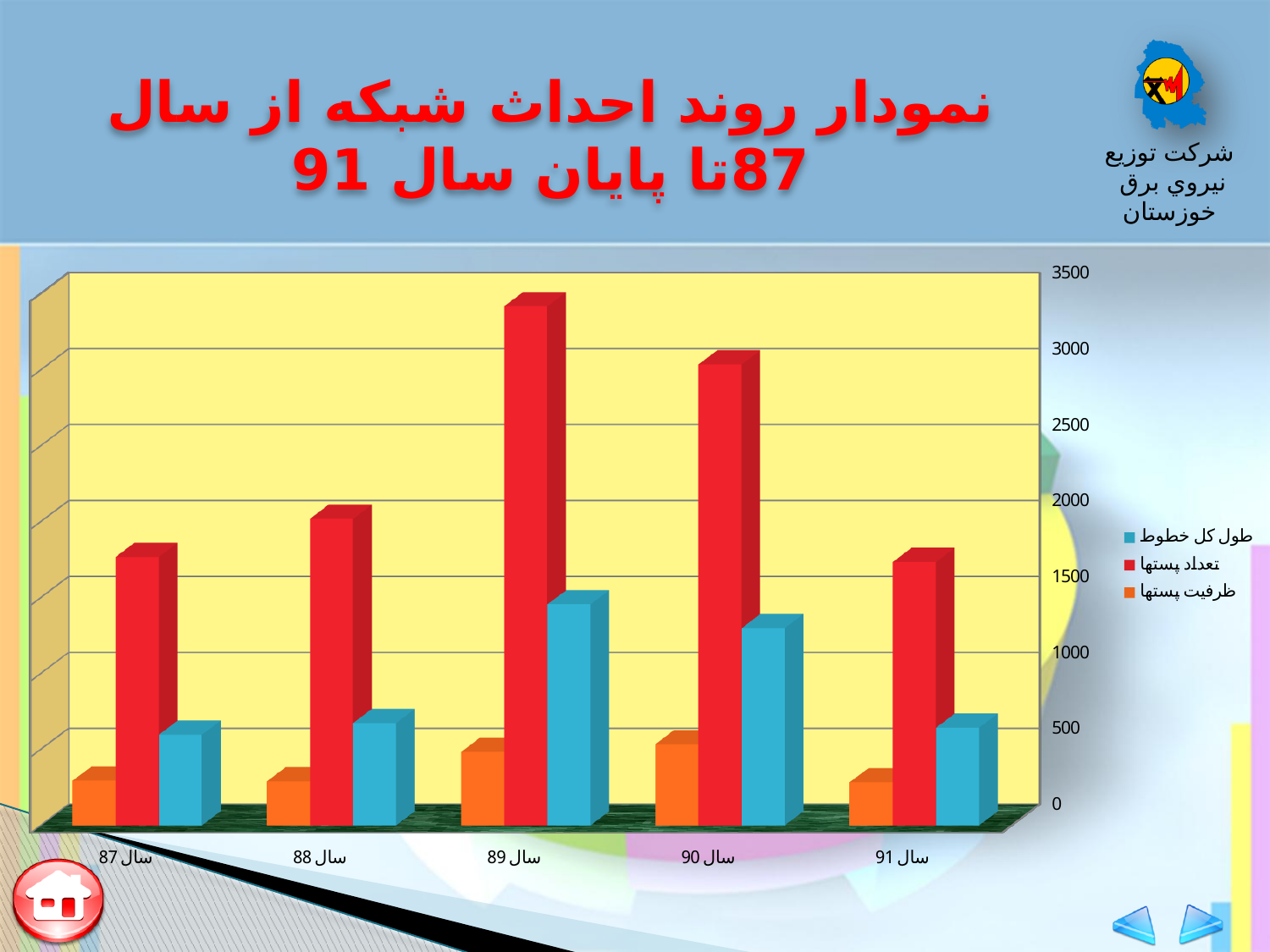
How many year categories are shown on the x axis of the chart? 5 Is the value of تعداد پستها for سال 89 greater or less than 3000? greater Which year has the highest value for تعداد پستها? سال 89 What kind of chart is shown on the slide? bar chart Which series is shown in red in the chart legend? تعداد پستها Which is larger: طول کل خطوط for سال 87 or for سال 89? سال 89 Is the value of طول کل خطوط for سال 89 greater or less than 1000? greater Which is larger: تعداد پستها for سال 89 or for سال 90? سال 89 Which year has the highest value for طول کل خطوط? سال 89 How many series does the chart legend list? 3